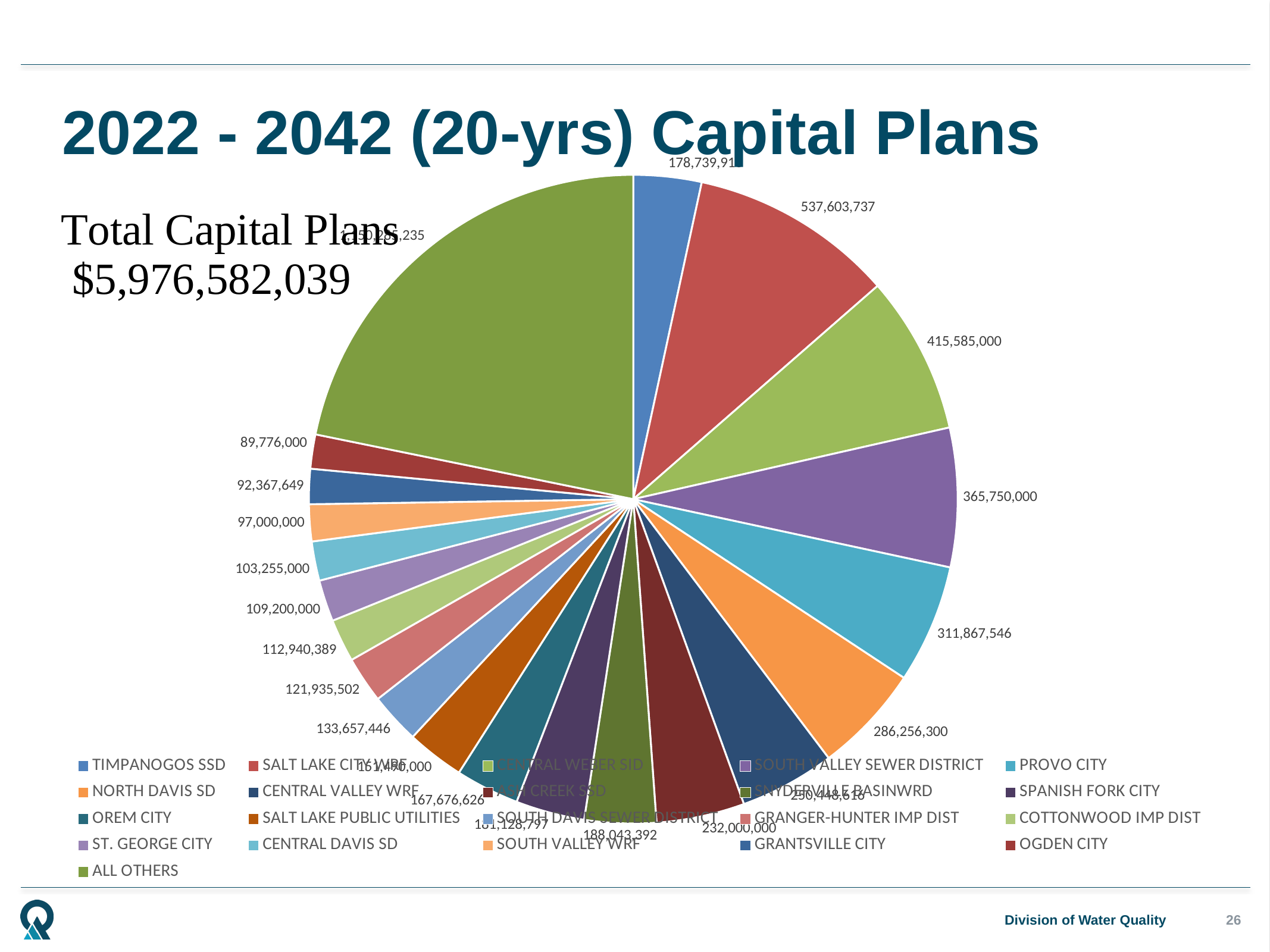
Which category has the largest slice of the pie? ALL OTHERS What is the value for PROVO CITY? 311,867,546 What is the title of the slide? 2022 - 2042 (20-yrs) Capital Plans What is the value for OGDEN CITY? 89,776,000 What total capital plans amount is stated on the slide? $5,976,582,039 What is the difference between the values for SALT LAKE CITY WRF and CENTRAL WEBER SID? 122,018,737 What is the value for CENTRAL WEBER SID? 415,585,000 Which category has the smallest slice of the pie? OGDEN CITY What kind of chart is shown on the slide? Pie chart What is the value for SALT LAKE CITY WRF? 537,603,737 How many categories does the legend list? 21 Which is larger, the value for CENTRAL WEBER SID or SOUTH VALLEY SEWER DISTRICT? CENTRAL WEBER SID